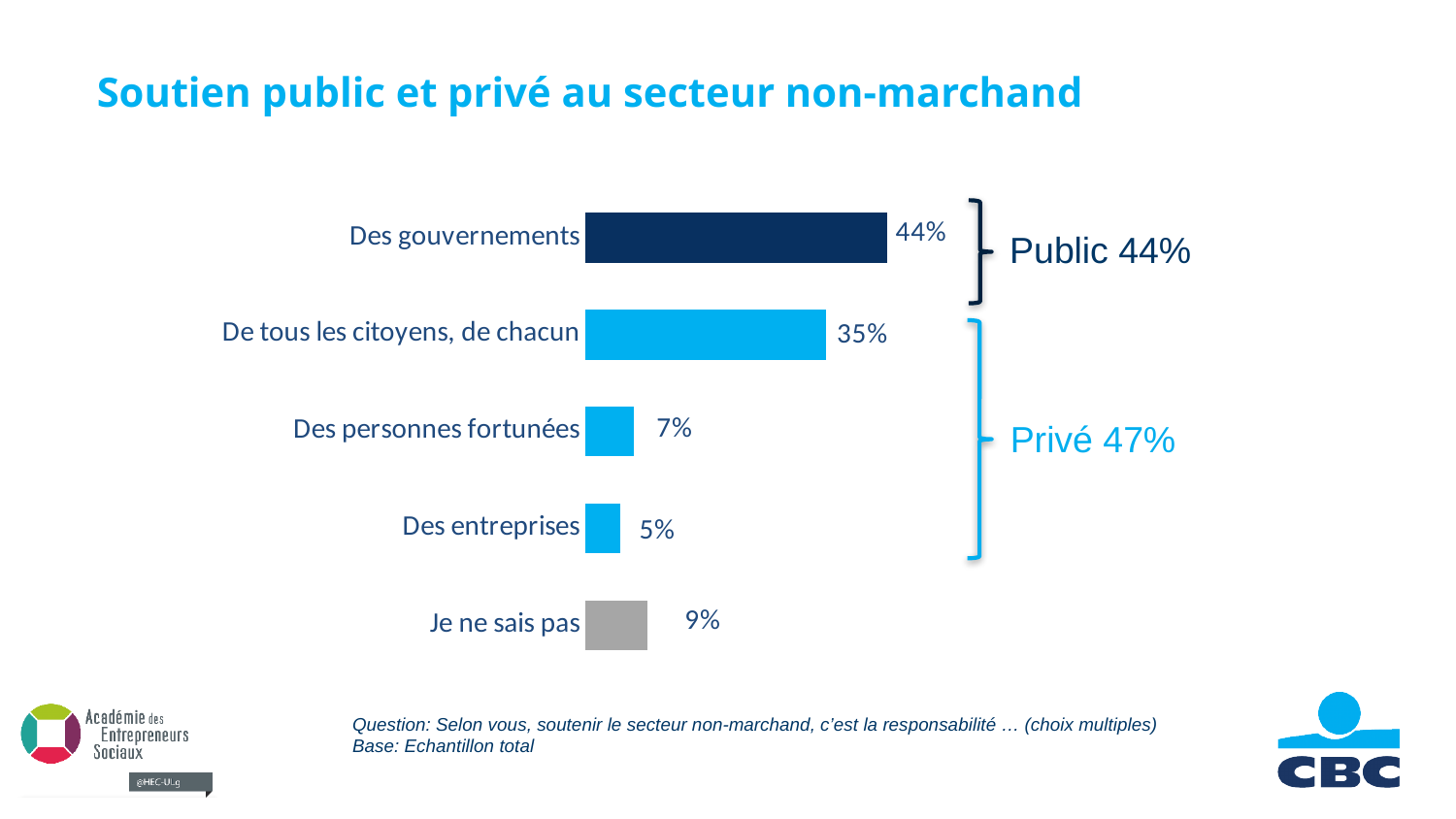
What is the difference between the values for "Des gouvernements" and "De tous les citoyens, de chacun"? 9% What is the value for "Des gouvernements"? 44% What kind of chart is shown on the slide? Bar chart What is the value for "Des entreprises"? 5% How many categories are shown in the chart? 5 What total is shown for the "Privé" group on the slide? 47% Which category has the highest value? Des gouvernements What is the value for "Des personnes fortunées"? 7% What is the value for "Je ne sais pas"? 9% Which is larger, the value for "Je ne sais pas" or the value for "Des personnes fortunées"? Je ne sais pas Which category has the lowest value? Des entreprises What is the value for "De tous les citoyens, de chacun"? 35%